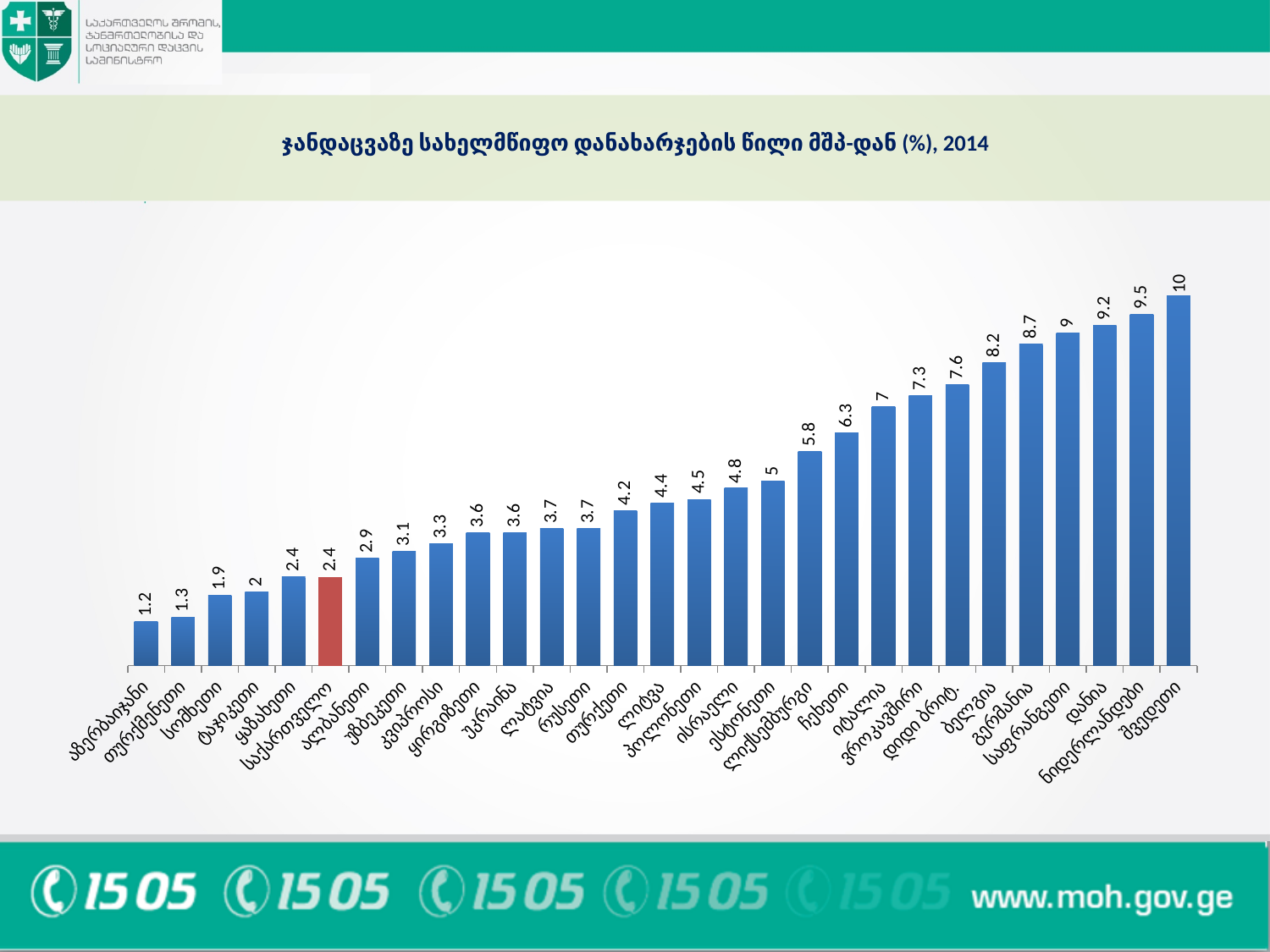
What is the value for საქართველო (Georgia), the red bar? 2.4 What is the difference between the values for შვედეთი (Sweden) and საქართველო (Georgia)? 7.6 Which category has the lowest value? აზერბაიჯანი (Azerbaijan) How many bars (categories) are plotted in the chart? 29 Which is larger, the value for ესტონეთი (Estonia) or the value for ლუქსემბურგი (Luxembourg)? ლუქსემბურგი (Luxembourg) What is the value for ევროკავშირი (EU)? 7.3 What is the value for შვედეთი (Sweden)? 10 What type of chart is shown on the slide? bar chart Which category has the highest value? შვედეთი (Sweden) Which bar is highlighted in a different colour (red) from the others? საქართველო (Georgia) Do the values rise or fall from left to right along the x axis? rise What is the value for გერმანია (Germany)? 8.7